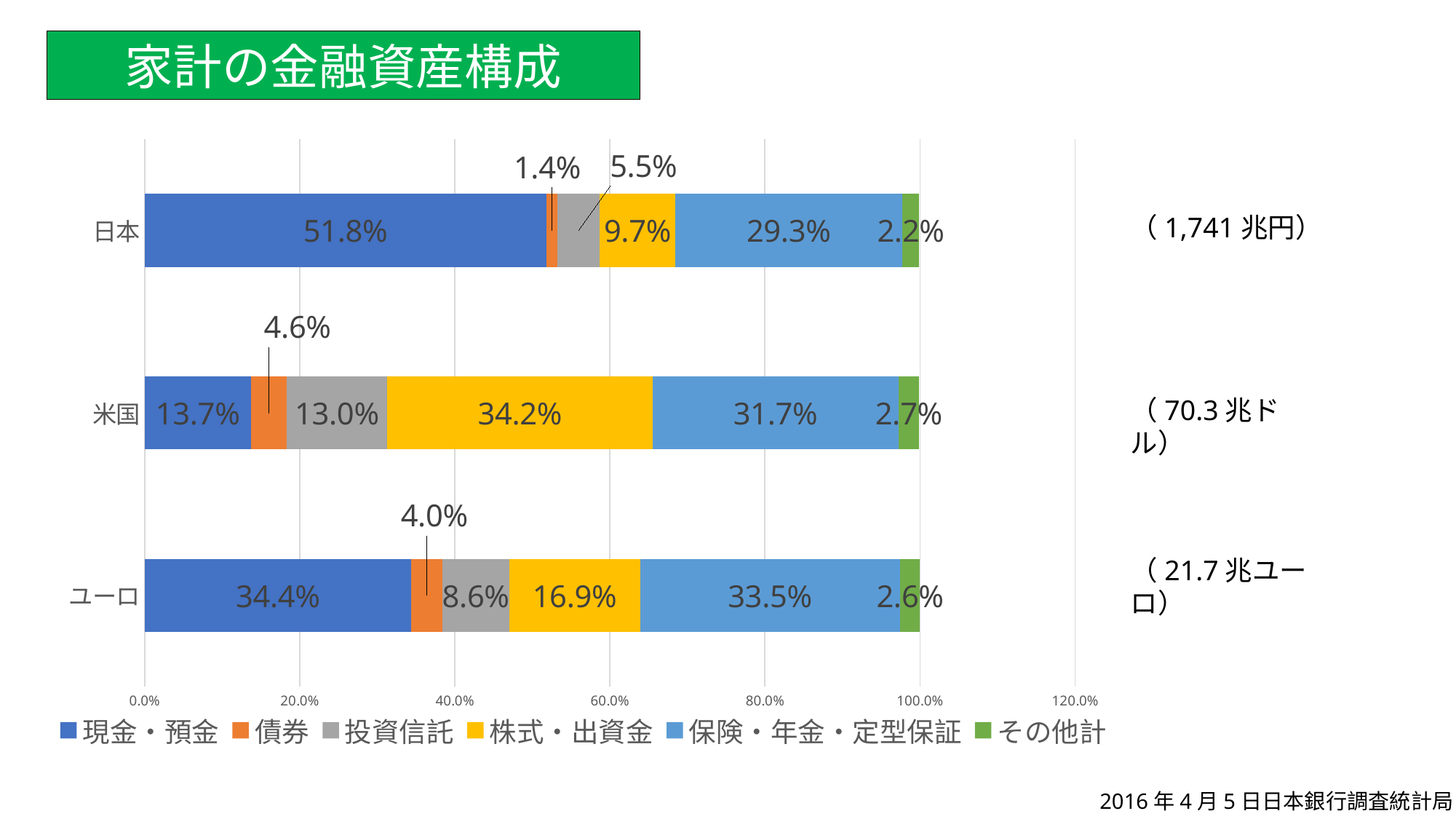
Which region has the highest share of 現金・預金? 日本 What is the value of 保険・年金・定型保証 for ユーロ? 33.5% What is the value of 現金・預金 for 日本? 51.8% What is the value of 投資信託 for 米国? 13.0% What is the difference between the 現金・預金 share of 日本 and that of 米国? 38.1 percentage points How many regions are shown in the chart? 3 What kind of chart is shown on the slide? Stacked bar chart What is the value of 株式・出資金 for 米国? 34.2% How many series does the legend list? 6 What is the title of the slide? 家計の金融資産構成 Which region has the lowest share of 債券? 日本 Which is larger: the 株式・出資金 share of 米国 or of ユーロ? 米国